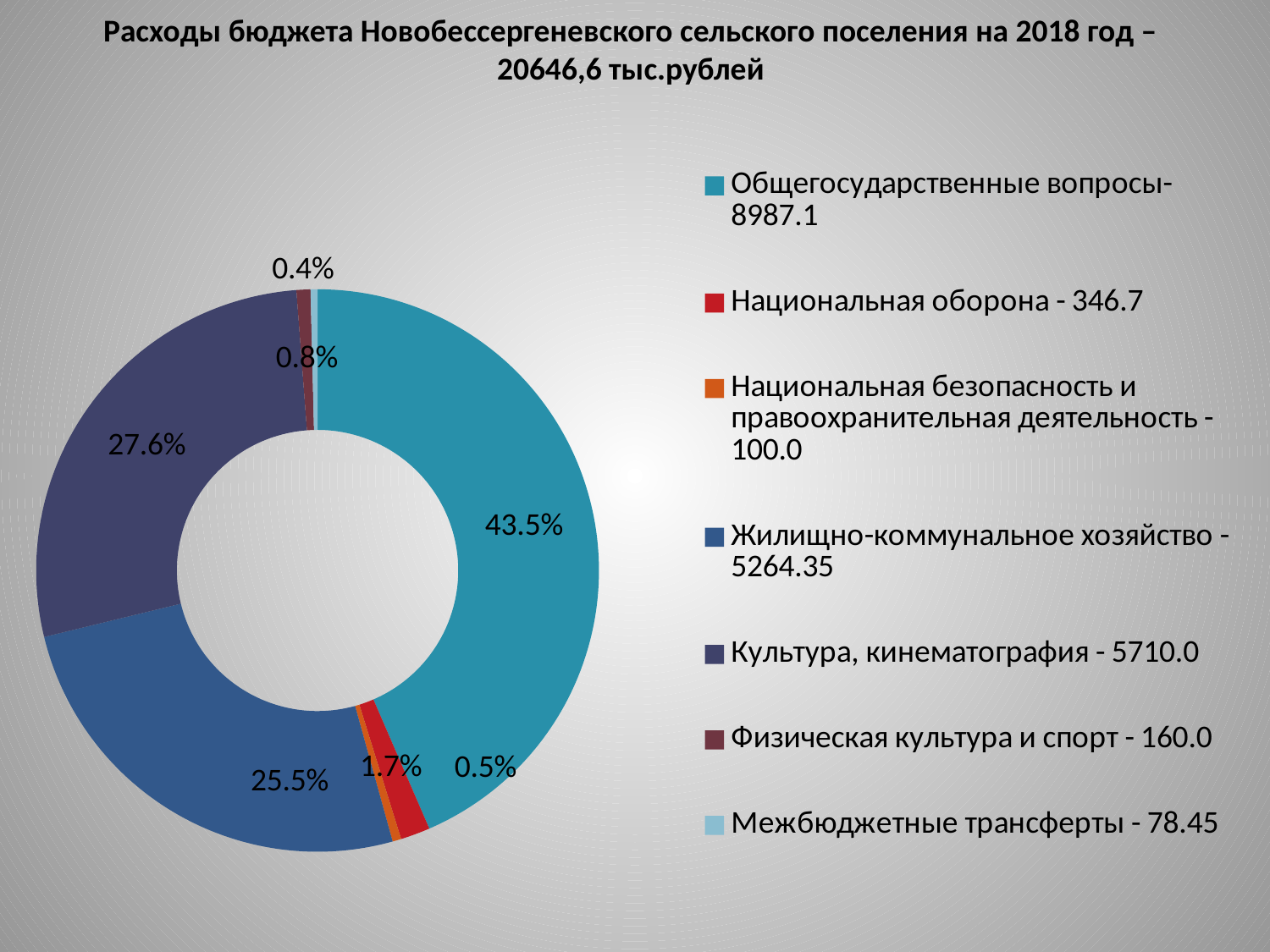
What percentage share is shown for Физическая культура и спорт? 0.8% Which category has the largest share of the budget expenses? Общегосударственные вопросы What percentage share is shown for Культура, кинематография? 27.6% What is the difference in percentage points between the shares of Общегосударственные вопросы and Культура, кинематография? 15.9 What percentage share is shown for Жилищно-коммунальное хозяйство? 25.5% How many categories does the legend list? 7 Which has a larger share: Культура, кинематография or Жилищно-коммунальное хозяйство? Культура, кинематография What amount (in thousand rubles) does the legend give for Национальная оборона? 346.7 What kind of chart is shown on the slide? Doughnut (pie) chart What total budget expense amount is stated in the chart title? 20646,6 тыс.рублей What percentage share is shown for Общегосударственные вопросы? 43.5% Which category has the smallest share of the budget expenses? Межбюджетные трансферты